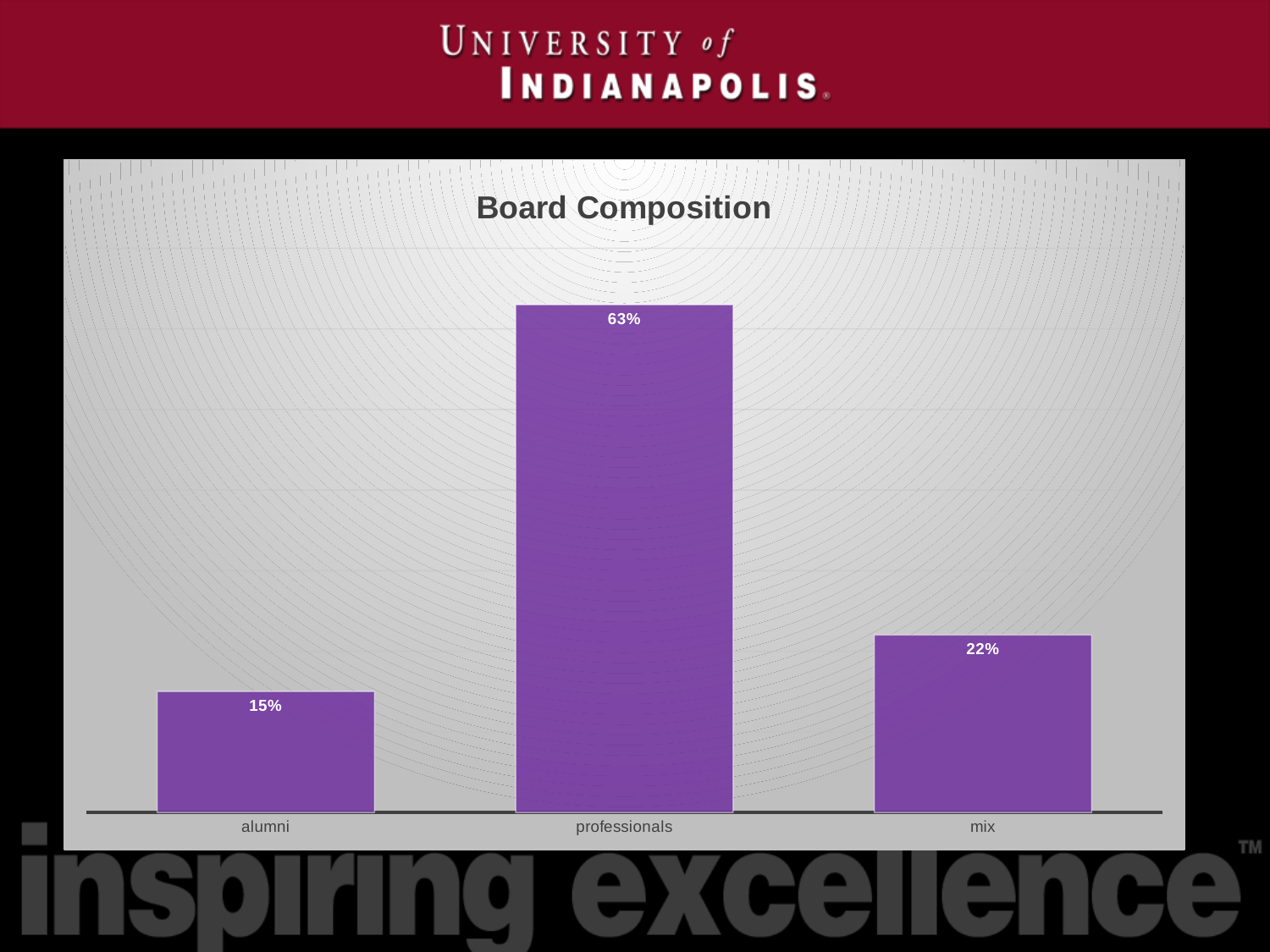
What kind of chart is shown on the slide? bar chart What is the difference between the values for mix and alumni? 7% What is the value for professionals in the Board Composition chart? 63% What is the value for mix in the Board Composition chart? 22% What is the title of the chart? Board Composition What is the difference between the values for professionals and mix? 41% How many categories are shown in the Board Composition chart? 3 Which category has the highest value in the Board Composition chart? professionals Which is larger, the value for mix or the value for alumni? mix Which category has the lowest value in the Board Composition chart? alumni What is the value for alumni in the Board Composition chart? 15% What colour are the bars in the chart? purple